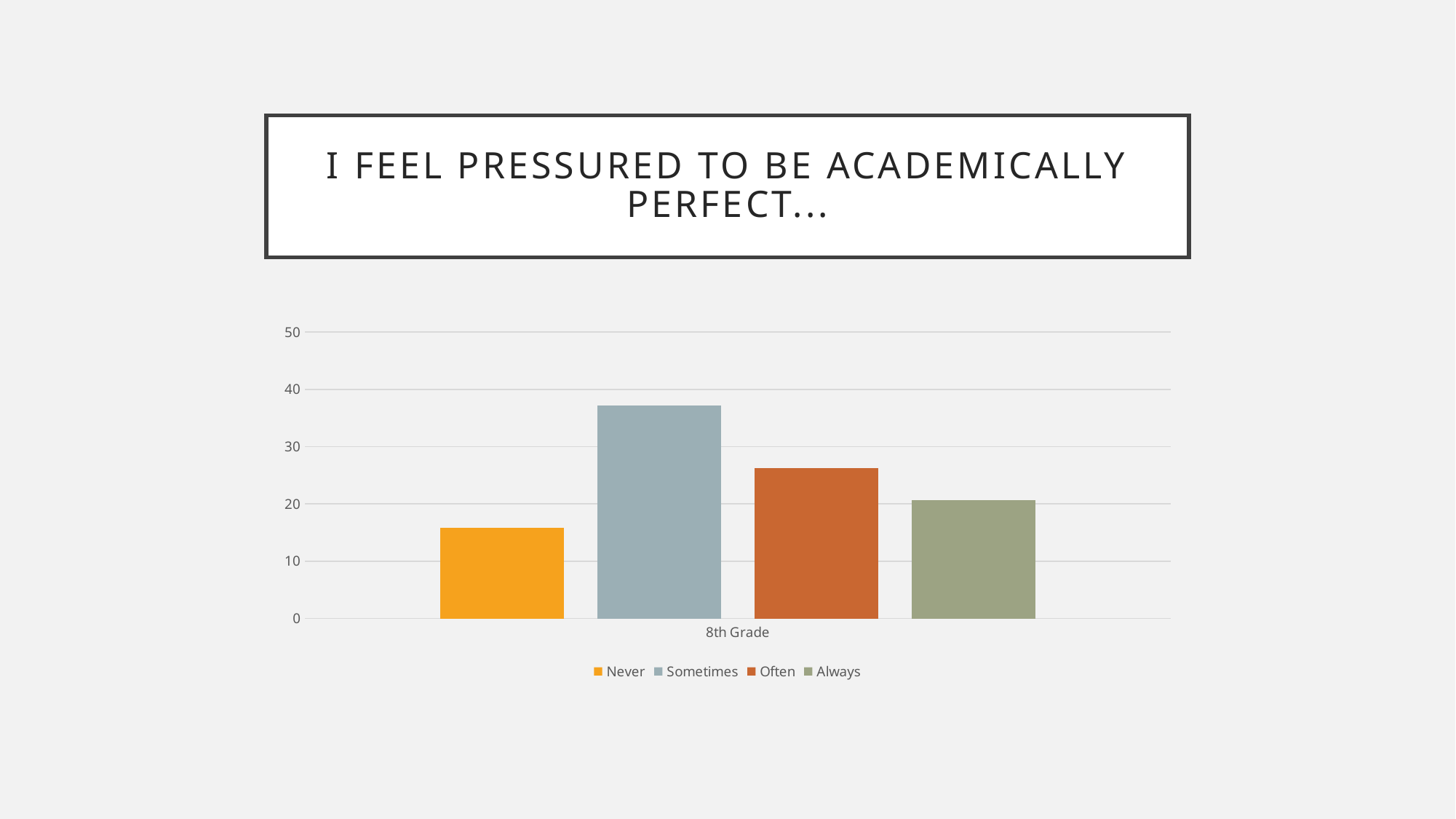
How many categories are shown on the x axis? 1 Is the value for Sometimes greater or less than 30? greater Which is larger for 8th Grade, Never or Always? Always Is the value for Never greater or less than 20? less What is the title shown above the chart? I FEEL PRESSURED TO BE ACADEMICALLY PERFECT... Which is larger for 8th Grade, Often or Always? Often How many series does the legend list? 4 Which series has the highest value for 8th Grade? Sometimes What is the label of the category on the x axis? 8th Grade Is the value for Often greater or less than 20? greater What kind of chart is shown on the slide? bar chart Which series has the lowest value for 8th Grade? Never